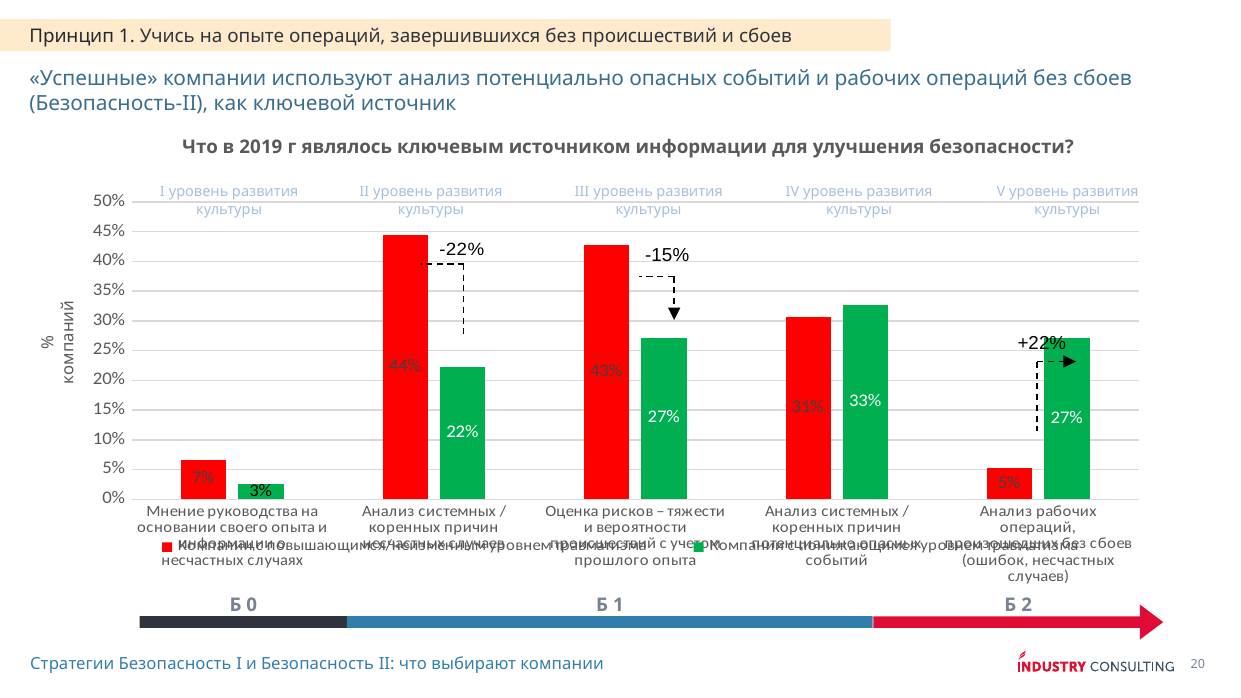
Какое значение красного столбца для категории «Анализ системных / коренных причин потенциально опасных событий»? 31% На сколько процентных пунктов красный столбец больше зелёного в категории «Оценка рисков – тяжести и вероятности происшествий с учетом прошлого опыта»? 16% Сколько рядов данных показано на диаграмме? 2 Какого типа эта диаграмма? столбчатая (bar chart) Какое значение зелёного столбца для категории «Анализ рабочих операций, произошедших без сбоев»? 27% Какое значение зелёного столбца для категории «Мнение руководства на основании своего опыта и информации о несчастных случаях»? 3% В какой категории красный столбец имеет наибольшее значение? Анализ системных / коренных причин несчастных случаев В какой категории зелёный столбец имеет наименьшее значение? Мнение руководства на основании своего опыта и информации о несчастных случаях Сколько категорий показано на оси X диаграммы? 5 Какое значение красного столбца для категории «Анализ системных / коренных причин несчастных случаев»? 44% Какая подпись оси Y на диаграмме? % компаний Какой столбец больше в категории «Анализ системных / коренных причин потенциально опасных событий» — красный или зелёный? зелёный